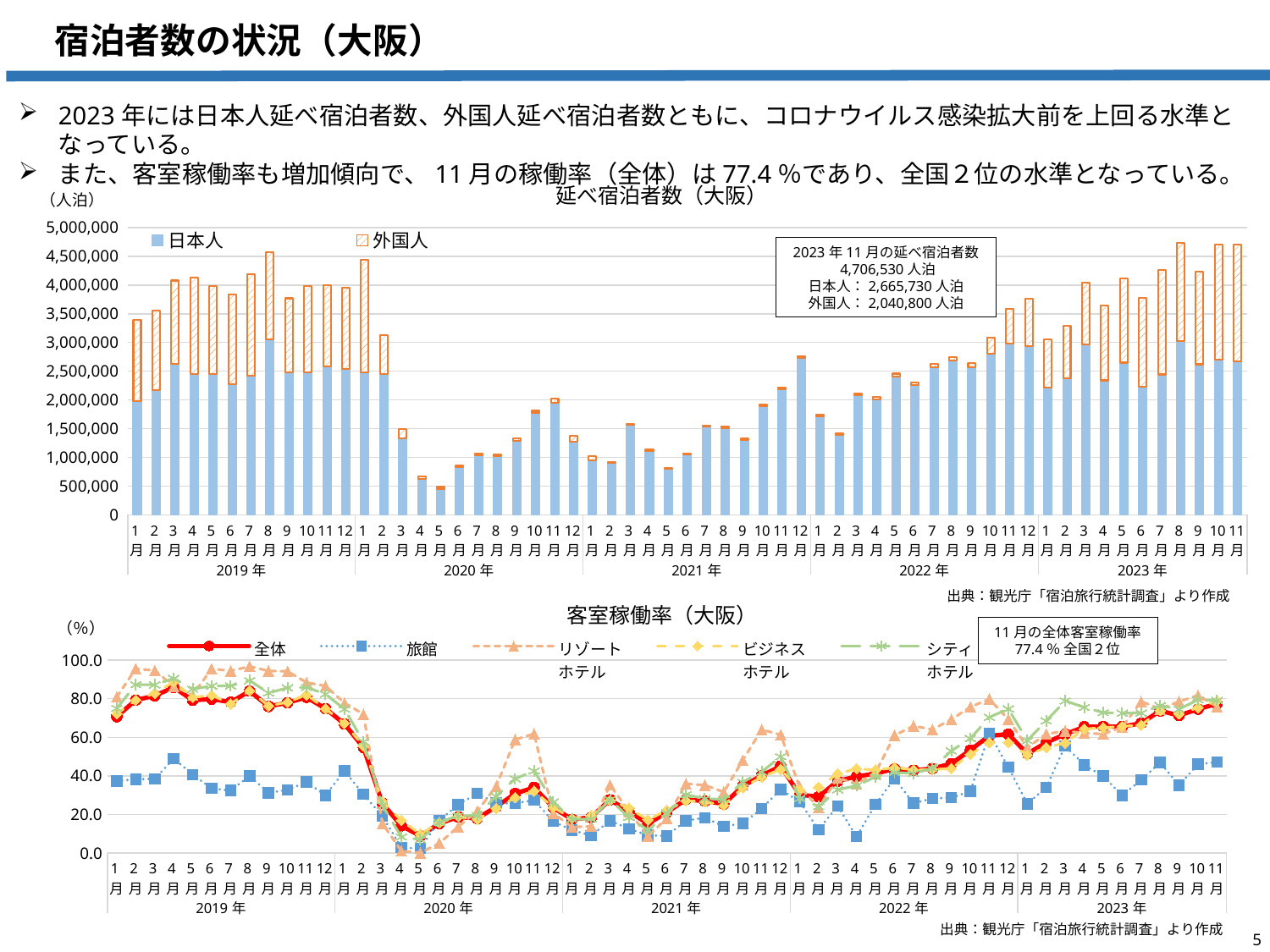
In the bottom chart 客室稼働率（大阪）, how many series does the legend list? 5 In the top chart 延べ宿泊者数（大阪）, what is the total number of overnight stays for 2023年11月 according to the annotation? 4,706,530 人泊 In the top chart 延べ宿泊者数（大阪）, how many series does the legend list? 2 In the top chart 延べ宿泊者数（大阪）, what is the 日本人 value for 2023年11月 according to the annotation? 2,665,730 人泊 In the top chart 延べ宿泊者数（大阪）, which is larger for 2023年11月, 日本人 or 外国人? 日本人 In the top chart 延べ宿泊者数（大阪）, is the total value for 2020年5月 greater or less than 1,000,000? less In the top chart 延べ宿泊者数（大阪）, what is the 外国人 value for 2023年11月 according to the annotation? 2,040,800 人泊 In the bottom chart 客室稼働率（大阪）, is the 旅館 value for 2020年5月 greater or less than 20.0? less What kind of chart is the top chart titled 延べ宿泊者数（大阪）? bar chart In the top chart 延べ宿泊者数（大阪）, what is the difference between the 日本人 and 外国人 values for 2023年11月? 624,930 人泊 In the top chart 延べ宿泊者数（大阪）, do the values rise or fall from 2020年1月 to 2020年5月? fall In the bottom chart 客室稼働率（大阪）, what is the 全体 occupancy rate for 11月 of 2023年 according to the annotation? 77.4%